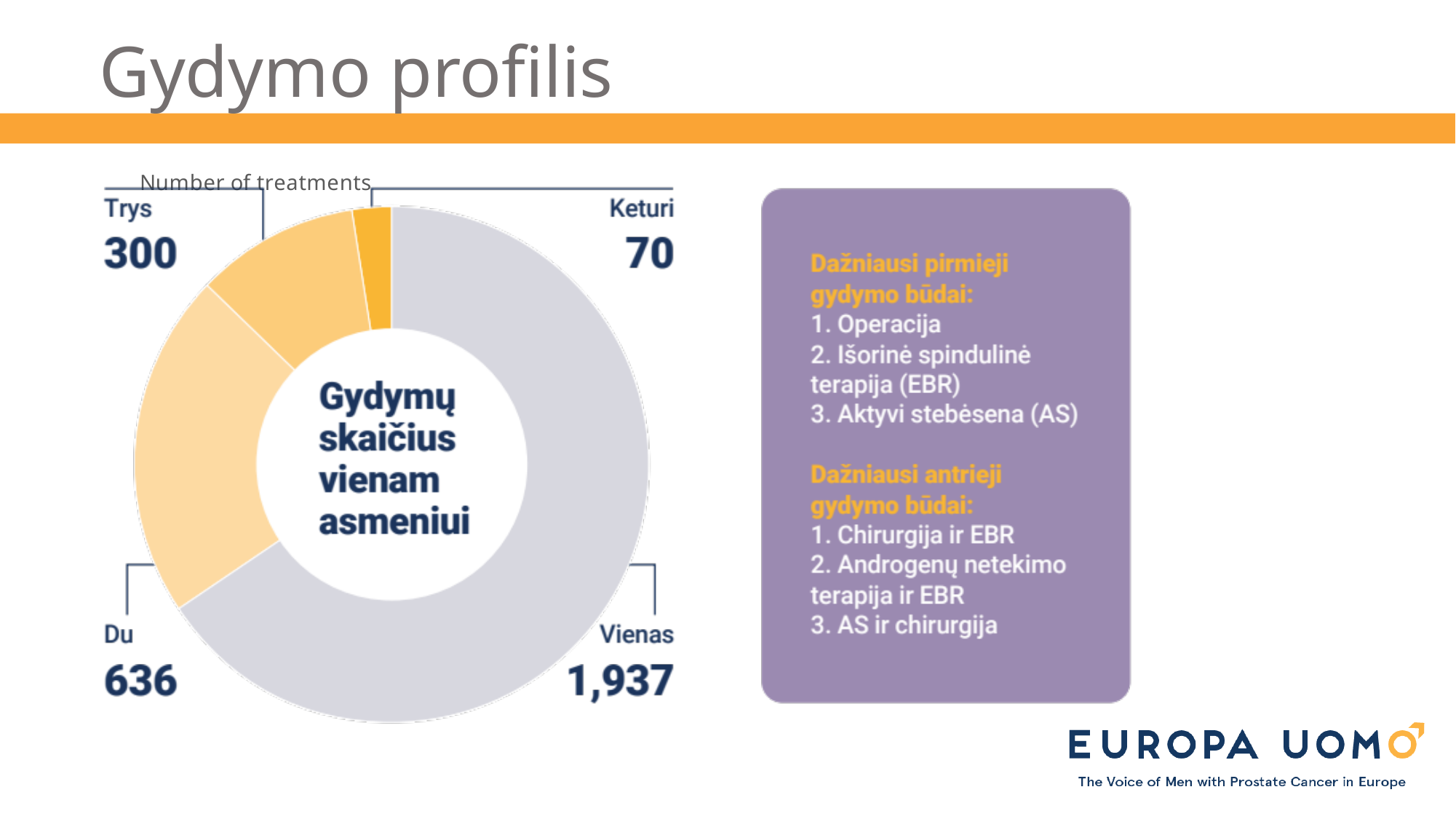
What is the value for the "Trys" segment of the donut chart? 300 Which category has the largest value in the donut chart? Vienas Which is larger, the value for "Trys" or the value for "Keturi"? Trys What is the total of all four values shown in the donut chart? 2,943 How many categories are shown in the donut chart? 4 What is the value for the "Keturi" segment of the donut chart? 70 What is the difference between the values for "Vienas" and "Du"? 1,301 What is the difference between the values for "Du" and "Trys"? 336 What kind of chart is shown on the slide? Pie (donut) chart What is the value for the "Vienas" segment of the donut chart? 1,937 Which category has the smallest value in the donut chart? Keturi What is the value for the "Du" segment of the donut chart? 636